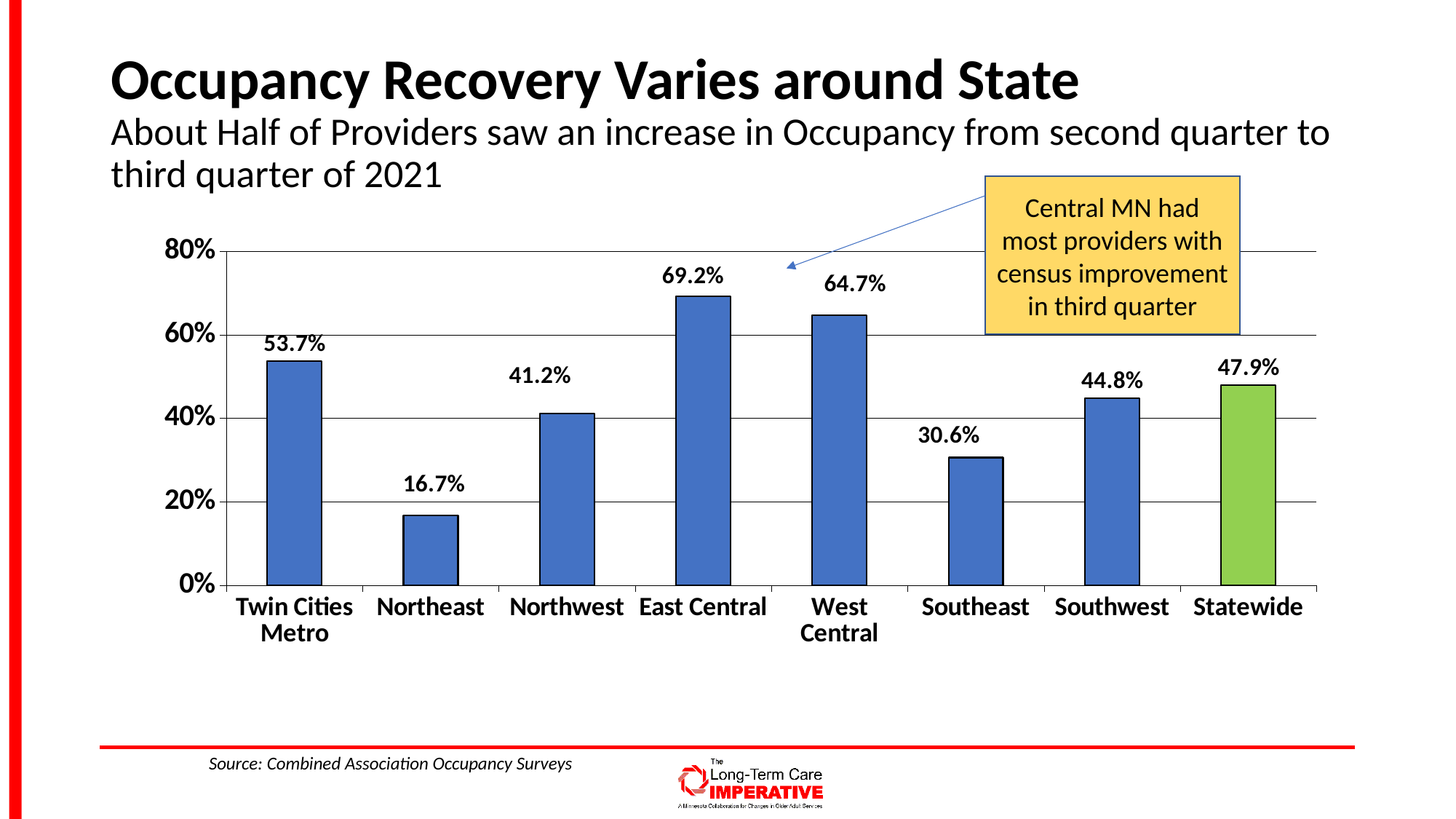
What is the difference between the Twin Cities Metro and Northeast values? 37.0% What is the Statewide value? 47.9% Which region has the highest value? East Central Which bar is coloured green rather than blue? Statewide What is the value for East Central? 69.2% Which region has the lowest value? Northeast What is the value for Northeast? 16.7% Which is larger, the value for Southwest or the value for Northwest? Southwest What is the difference between the East Central and West Central values? 4.5% What kind of chart is shown on the slide? bar chart Is the value for Southeast greater or less than 40%? less How many bars are shown in the chart? 8